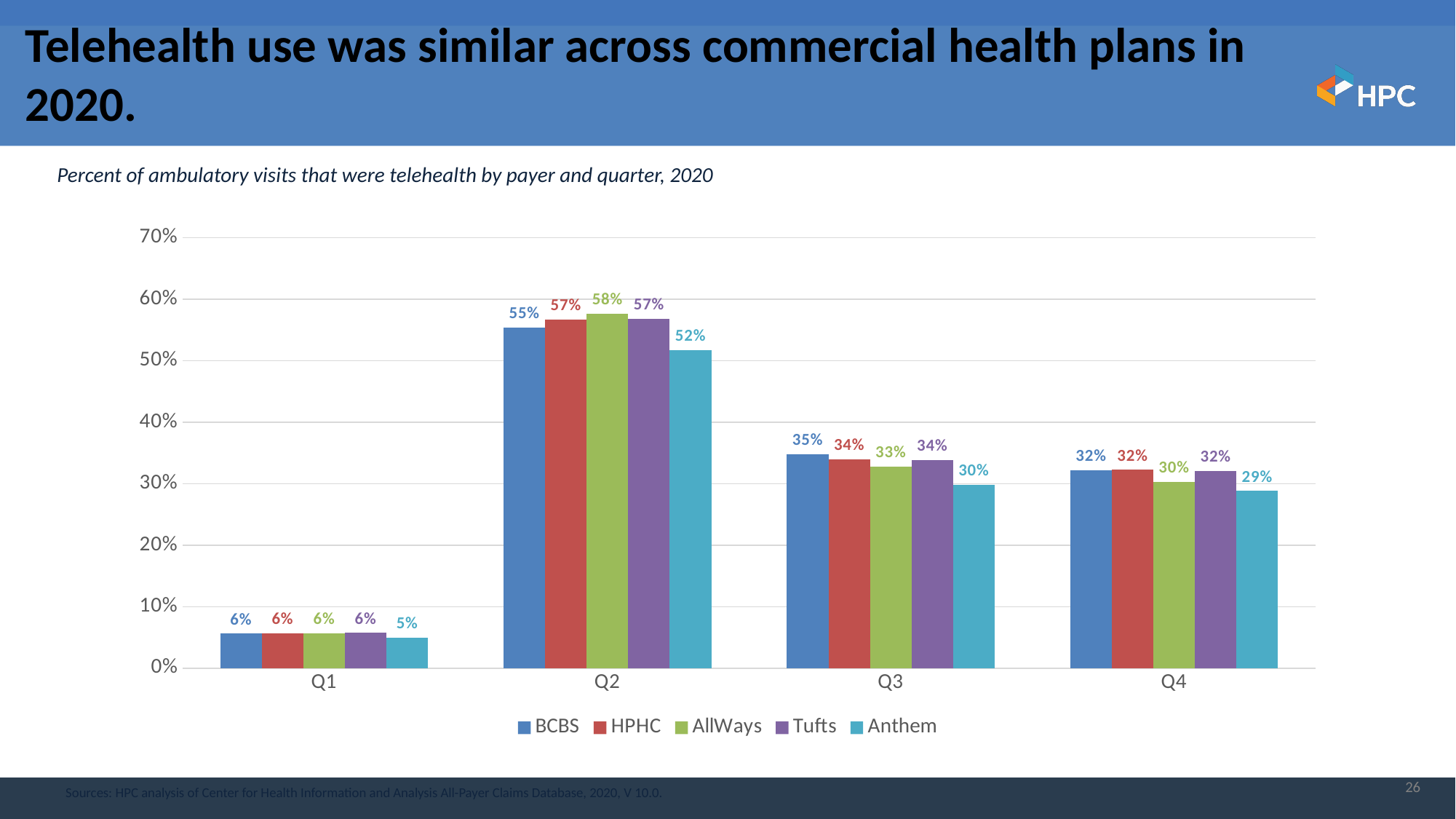
How many quarters are shown on the x axis? 4 What is the difference between the AllWays and Anthem values in Q2? 6% How many payers does the legend list? 5 What percent of ambulatory visits were telehealth for BCBS in Q2? 55% Which payer has the highest value in Q2? AllWays Which payer has the lowest value in Q3? Anthem What is the value for Anthem in Q4? 29% Which is larger, the BCBS value in Q3 or the Anthem value in Q3? BCBS Do the values for HPHC rise or fall from Q2 to Q4? Fall What is the value for AllWays in Q3? 33% What kind of chart is shown on the slide? Bar chart Is the value for Tufts in Q2 greater or less than 50%? greater